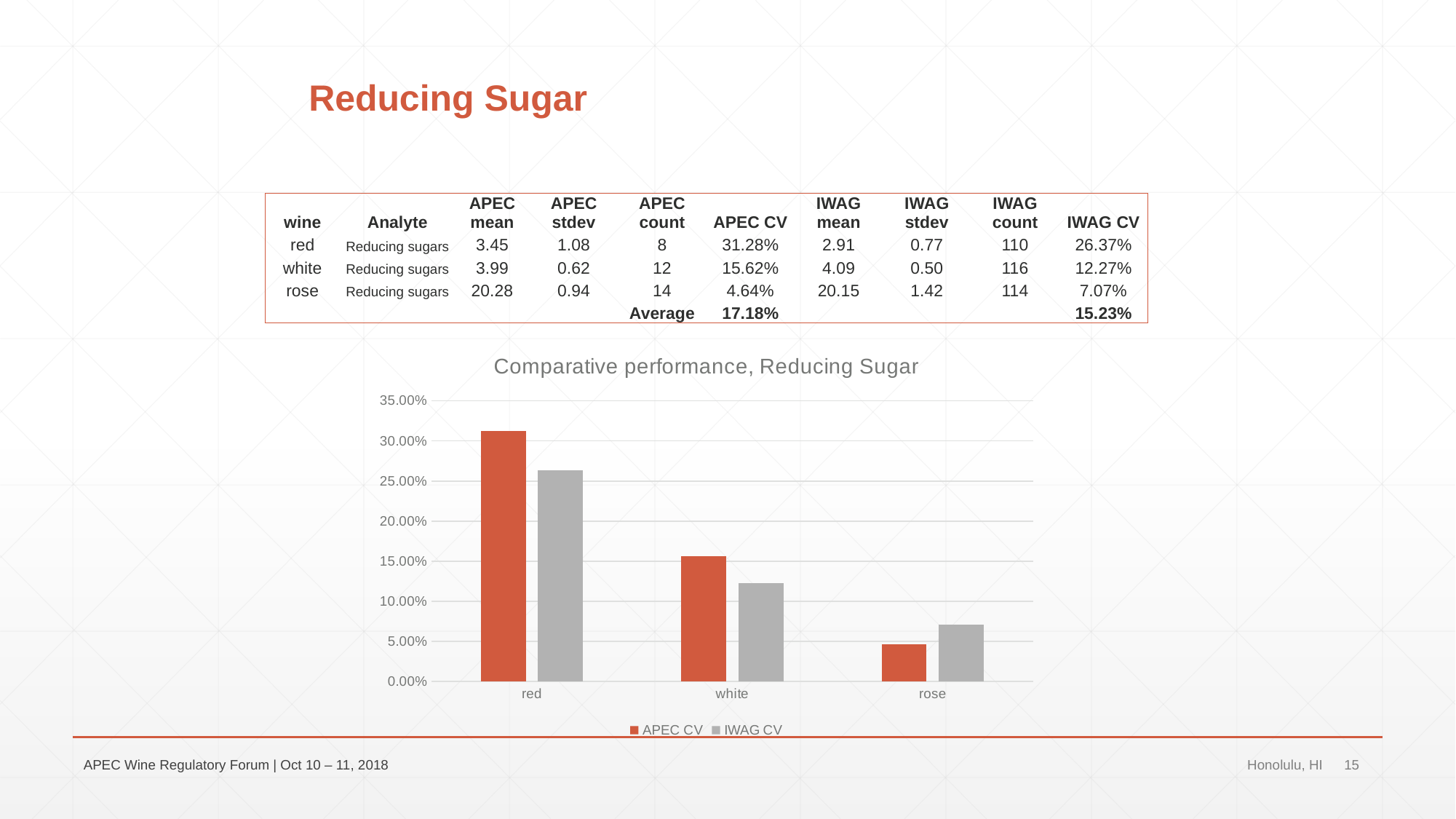
For white, which is larger, the APEC CV or the IWAG CV? APEC CV What is the APEC CV for red wine, as printed in the table on the slide? 31.28% Which wine has the highest APEC CV in the chart? red What kind of chart is shown on the slide? bar chart How many series does the chart legend list? 2 Which wine has the lowest IWAG CV in the chart? rose Is the IWAG CV for white greater or less than 15.00%? less What is the title of the chart? Comparative performance, Reducing Sugar For rose, which is larger, the APEC CV or the IWAG CV? IWAG CV How many wine categories are shown on the x axis of the chart? 3 Is the APEC CV for red greater or less than 30.00%? greater Do the APEC CV values rise or fall moving from red to rose along the x axis? fall